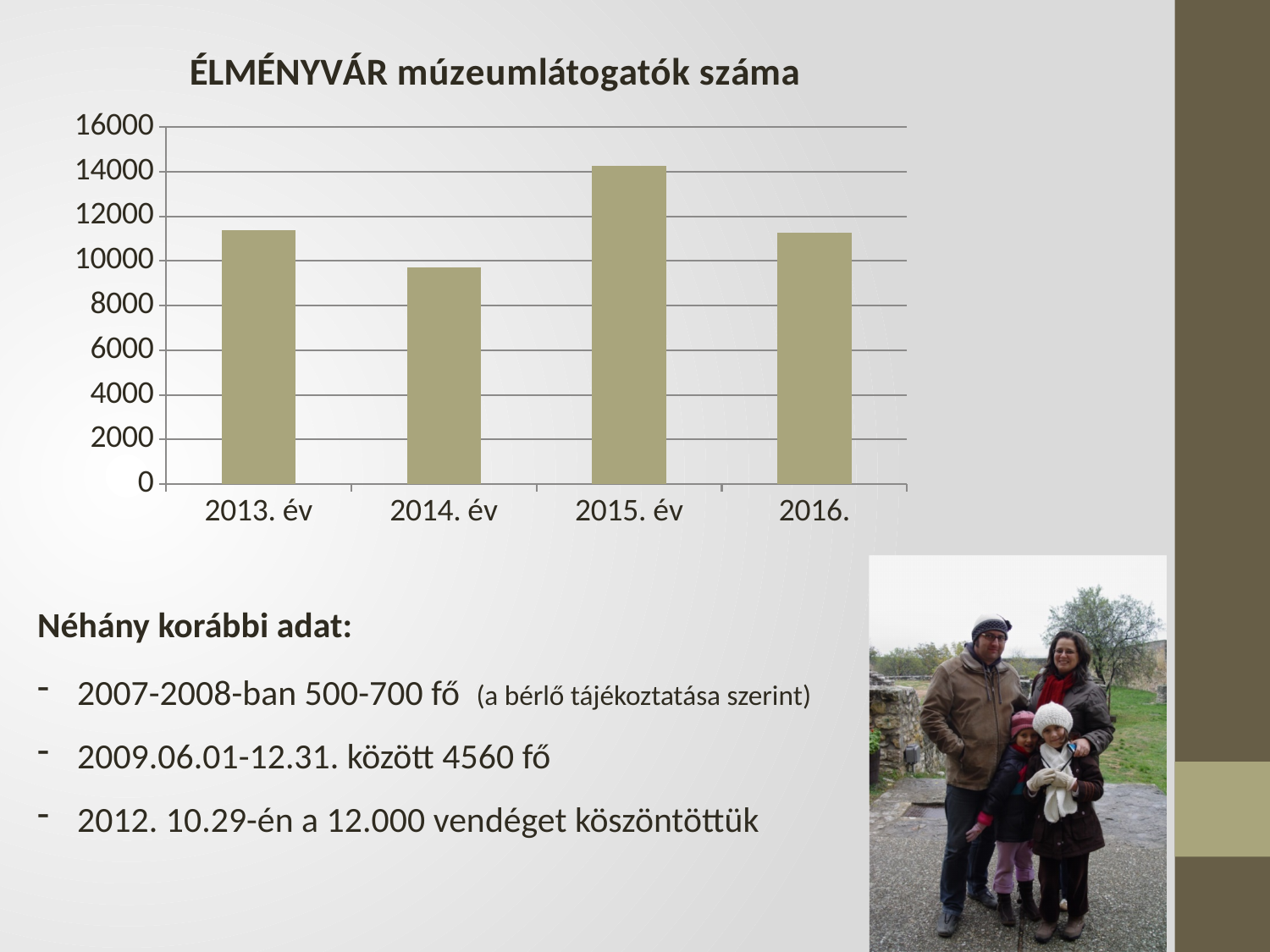
Does the number of visitors rise or fall from 2014. év to 2015. év? rise Which is larger, the value for 2013. év or the value for 2014. év? 2013. év How many categories (years) are shown on the x axis of the chart? 4 What is the title of the chart? ÉLMÉNYVÁR múzeumlátogatók száma Which year has the highest number of museum visitors in the chart? 2015. év Which is larger, the value for 2015. év or the value for 2016.? 2015. év Which year has the lowest number of museum visitors in the chart? 2014. év Is the value for 2015. év greater or less than 12000? greater What kind of chart is shown on the slide? bar chart Is the value for 2013. év greater or less than 10000? greater Is the value for 2016. greater or less than 12000? less